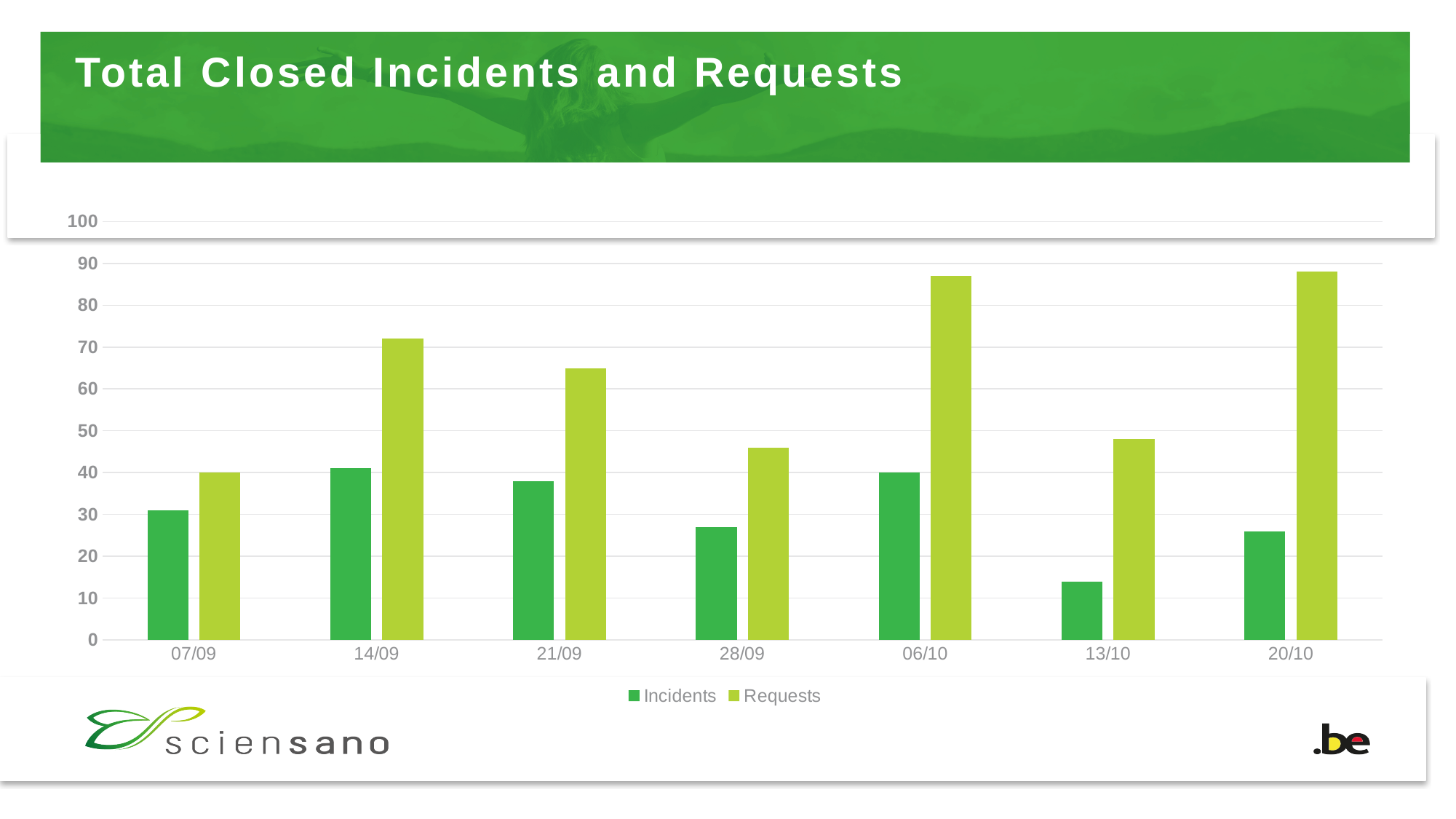
Is the Incidents value for 28/09 greater or less than 30? less Is the Requests value for 21/09 greater or less than 60? greater How many dates are shown along the x axis? 7 On which date is the Incidents value lowest? 13/10 What is the title of the chart? Total Closed Incidents and Requests What kind of chart is shown on the slide? bar chart Is the Requests value for 06/10 greater or less than 80? greater On 14/09, which is larger: Incidents or Requests? Requests Which date has the larger Incidents value: 07/09 or 13/10? 07/09 How many series does the legend list? 2 On which date is the Requests value lowest? 07/09